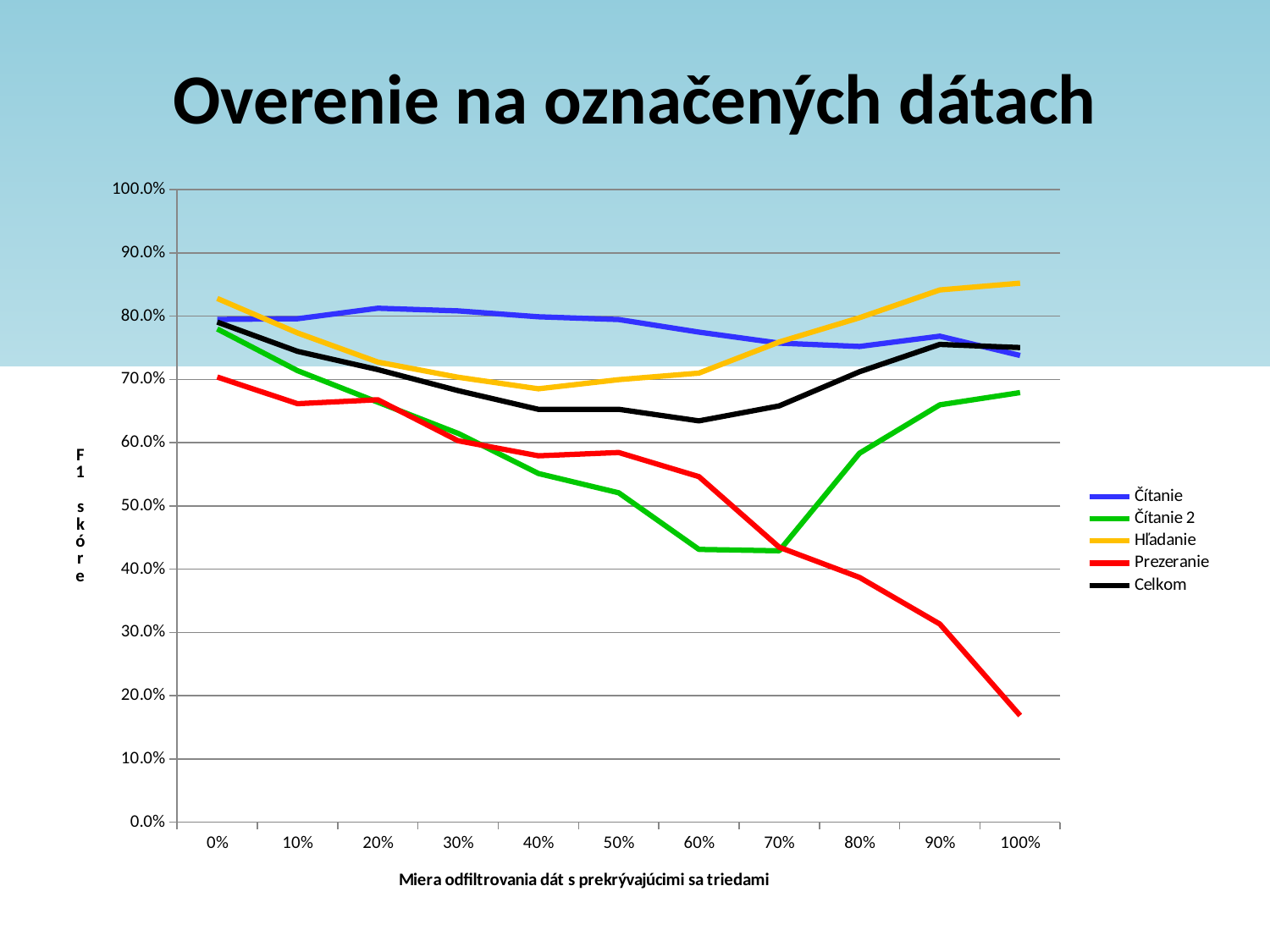
How many series does the legend list? 5 Is the value for Čítanie 2 at 60% greater or less than 50.0%? less What is the title of the x axis? Miera odfiltrovania dát s prekrývajúcimi sa triedami Is the value for Hľadanie at 100% greater or less than 80.0%? greater Which series has the lowest value at 100%? Prezeranie Is the value for Prezeranie at 100% greater or less than 20.0%? less What kind of chart is shown on the slide? line chart How many points are there along the x axis? 11 At 0%, which is larger: Hľadanie or Prezeranie? Hľadanie Which series has the highest value at 100%? Hľadanie Does the Prezeranie series rise or fall overall from 0% to 100%? fall At 100%, which is larger: Čítanie or Prezeranie? Čítanie